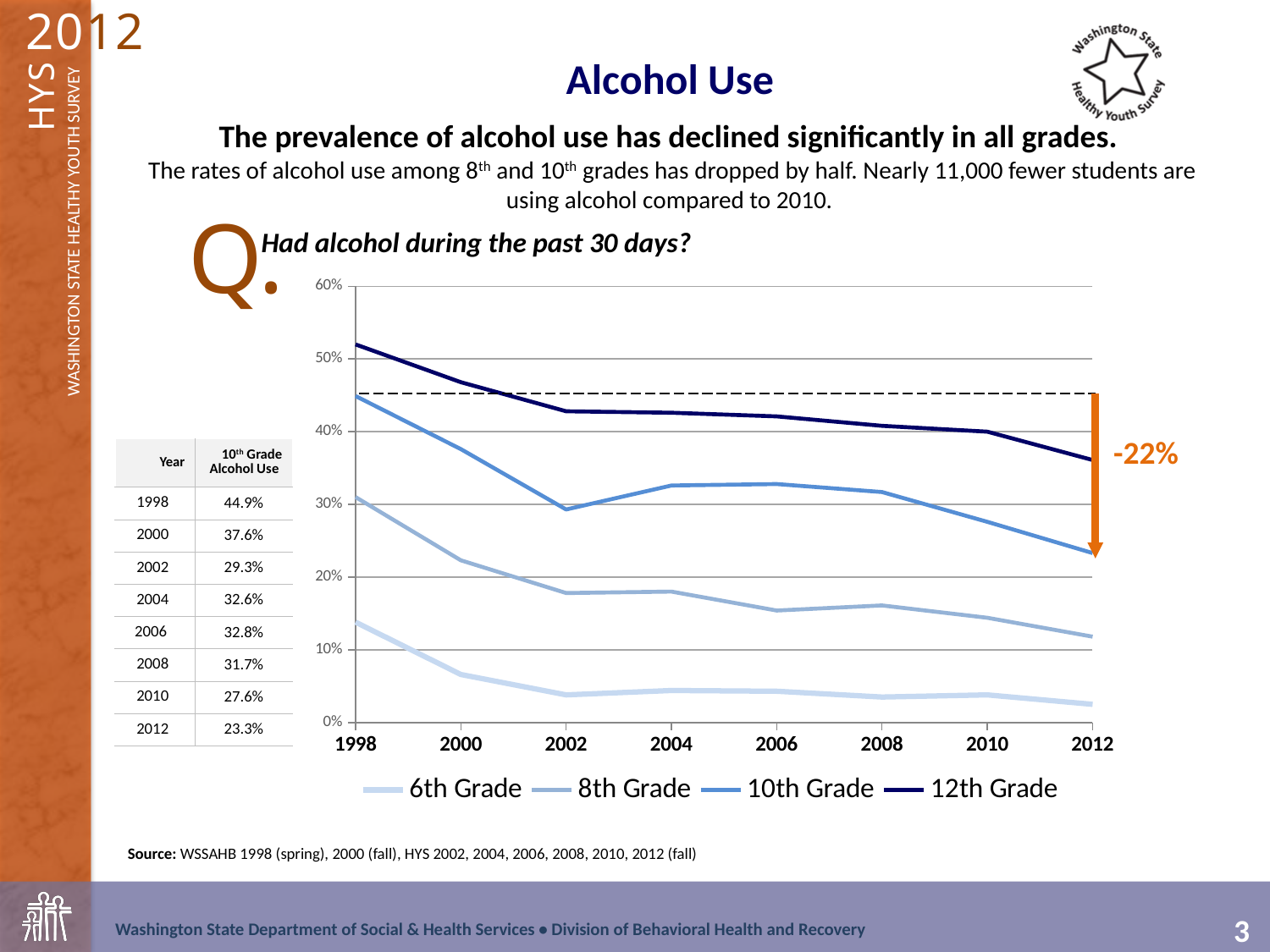
Is the value for 8th Grade in 2006 greater or less than 20%? less Is the value for 6th Grade in 1998 greater or less than 10%? greater What kind of chart is shown on the slide? line chart How many years are plotted along the x axis of the chart? 8 Which is larger for 10th Grade alcohol use: the value in 2002 or the value in 2004? 2004 Is the value for 12th Grade in 1998 greater or less than 50%? greater How many series does the chart legend list? 4 Which grade has the lowest alcohol use in 1998? 6th Grade According to the table, what was the 10th Grade alcohol use in 2012? 23.3% Which grade has the highest alcohol use in 2012? 12th Grade Does the 12th Grade line rise or fall from 1998 to 2012? fall